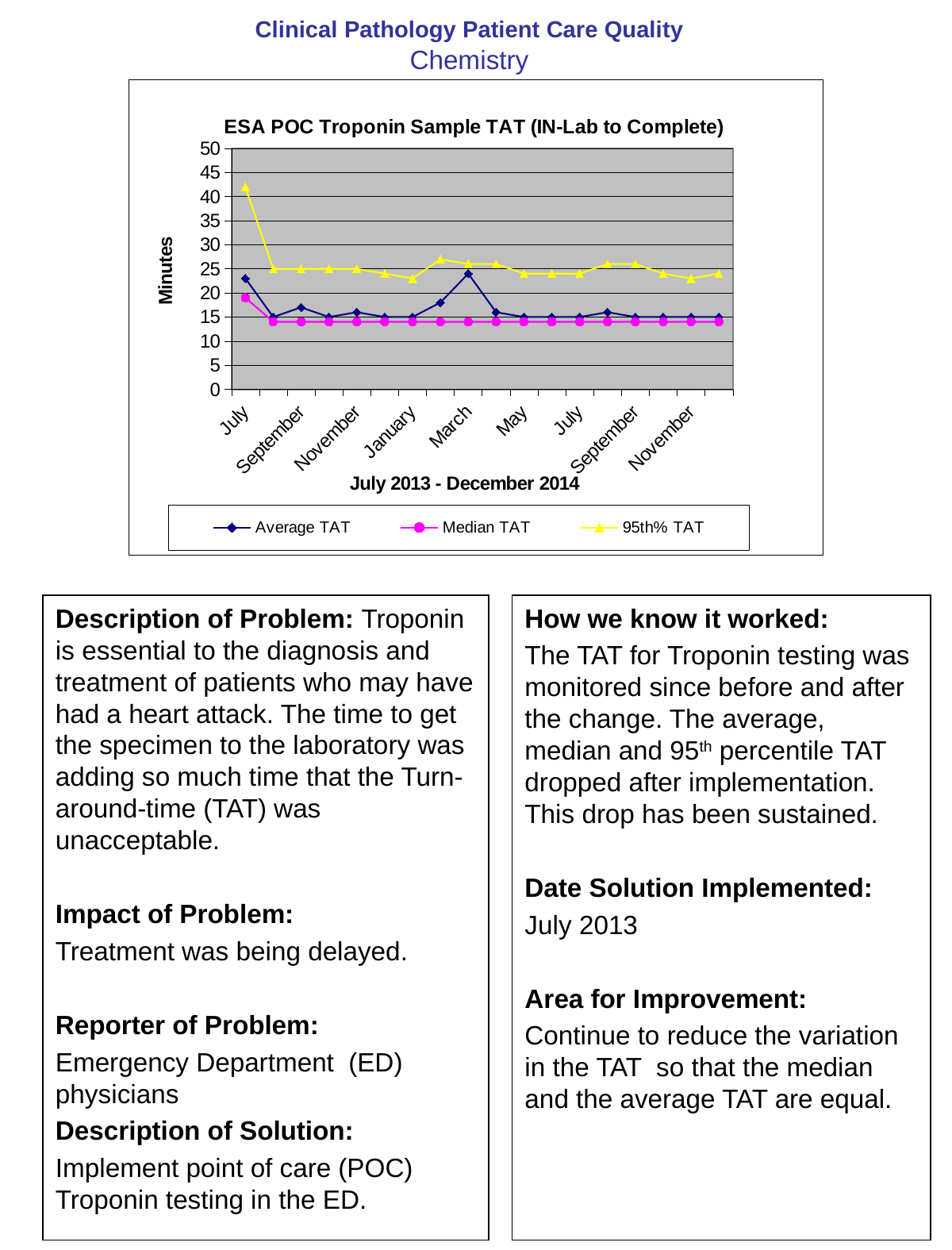
Does the 95th% TAT series rise or fall between the first July and the first September? fall Is the Average TAT value for March greater or less than 20? greater In which month does the 95th% TAT series reach its highest value? July (the first July) Is the 95th% TAT value for the first July greater or less than 40? greater How many series does the chart legend list? 3 In March, which is larger: the Average TAT or the Median TAT? Average TAT What is the title of the chart? ESA POC Troponin Sample TAT (IN-Lab to Complete) Is the Median TAT value for the first September greater or less than 20? less What is the label on the vertical axis of the chart? Minutes What kind of chart is shown on the slide? line chart Which series has the highest values across the chart? 95th% TAT How many month labels are shown on the x axis? 9